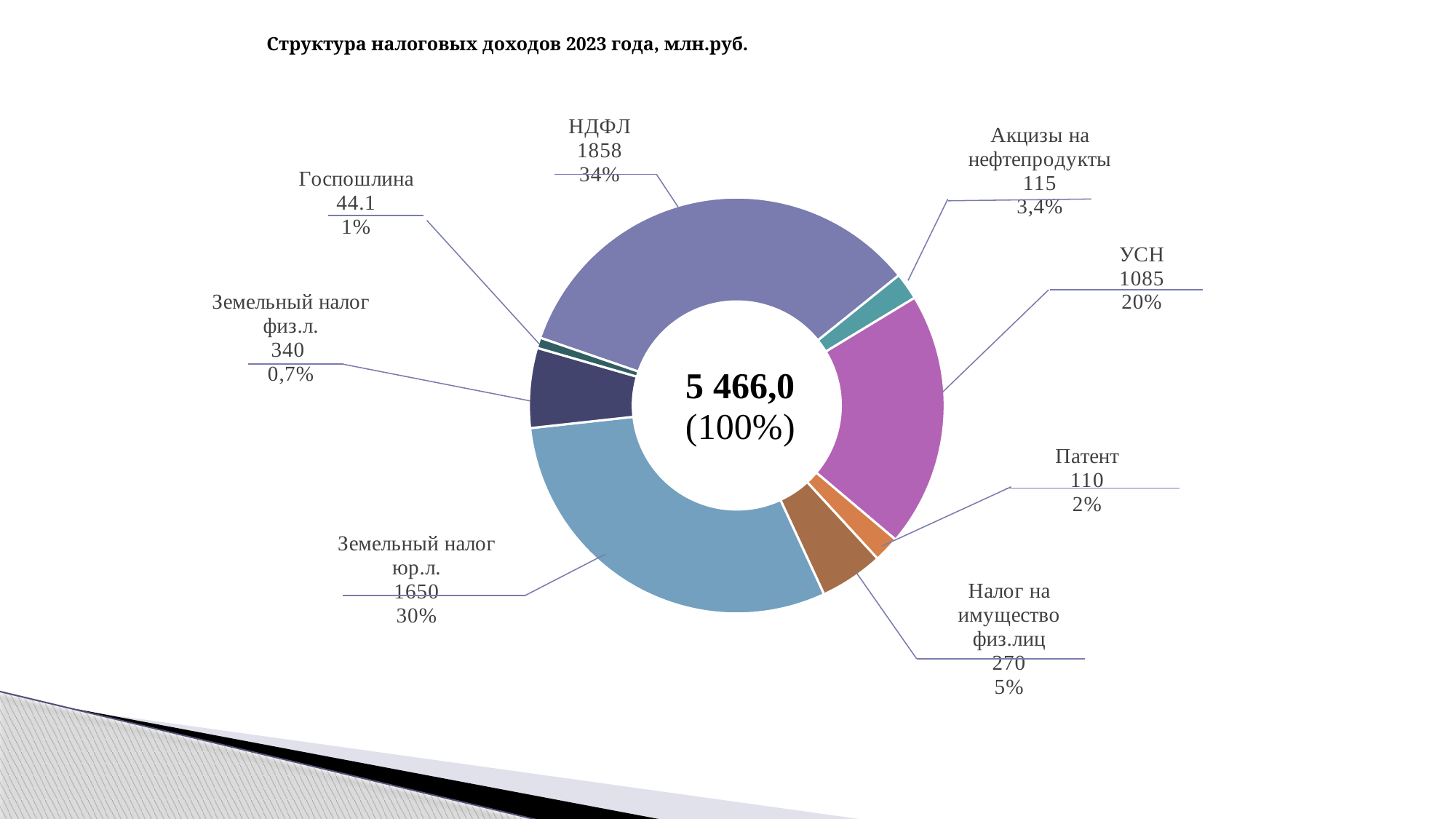
What total value is shown in the centre of the chart? 5 466,0 What kind of chart is shown on the slide? Doughnut (pie) chart What share of the chart does Акцизы на нефтепродукты represent? 3,4% What share of the chart does Земельный налог юр.л. represent? 30% How many categories are shown in the chart? 8 What is the value for УСН? 1085 What is the value for НДФЛ? 1858 Which is larger, the value for Патент or the value for Налог на имущество физ.лиц? Налог на имущество физ.лиц What is the title of the chart? Структура налоговых доходов 2023 года, млн.руб. Which category has the lowest value? Госпошлина Which category has the highest value? НДФЛ What is the difference between the values for НДФЛ and Земельный налог юр.л.? 208